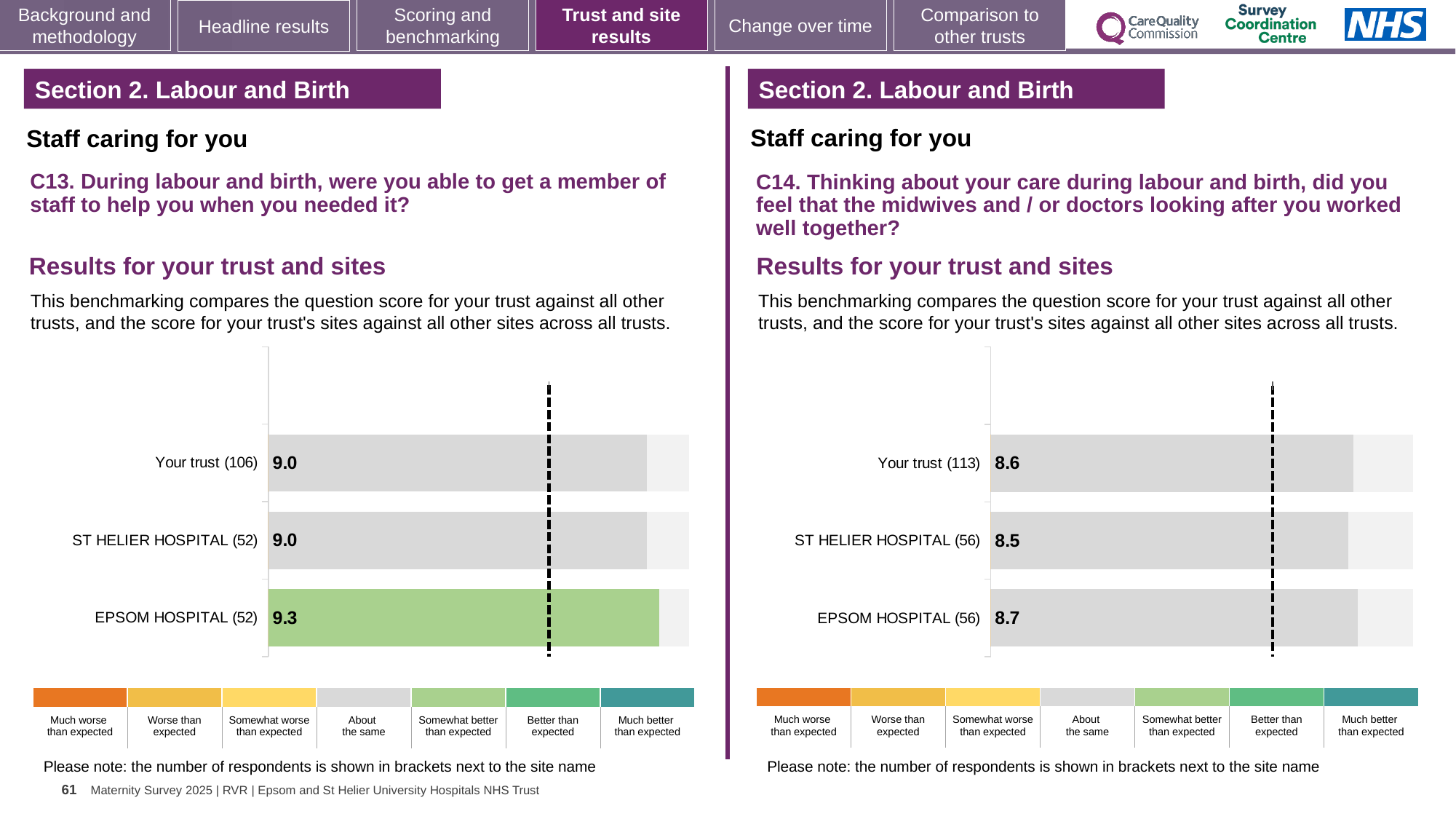
In the C14 chart on the right, is the score for EPSOM HOSPITAL larger or smaller than the score for Your trust? larger In the C13 chart on the left, what is the difference between the EPSOM HOSPITAL score and the ST HELIER HOSPITAL score? 0.3 In the C13 chart on the left, what is the score for Your trust? 9.0 In the C14 chart on the right, which site or trust has the highest score? EPSOM HOSPITAL In the C14 chart on the right, what is the score for Your trust? 8.6 In the C13 chart on the left, how many respondents are shown in brackets for Your trust? 106 How many bars are plotted in the C13 chart on the left? 3 In the C14 chart on the right, what is the score for ST HELIER HOSPITAL? 8.5 In the C14 chart on the right, which site or trust has the lowest score? ST HELIER HOSPITAL What kind of chart is used for the C14 results on the right? bar chart In the C13 chart on the left, what is the score for EPSOM HOSPITAL? 9.3 In the C13 chart on the left, which site or trust has the highest score? EPSOM HOSPITAL